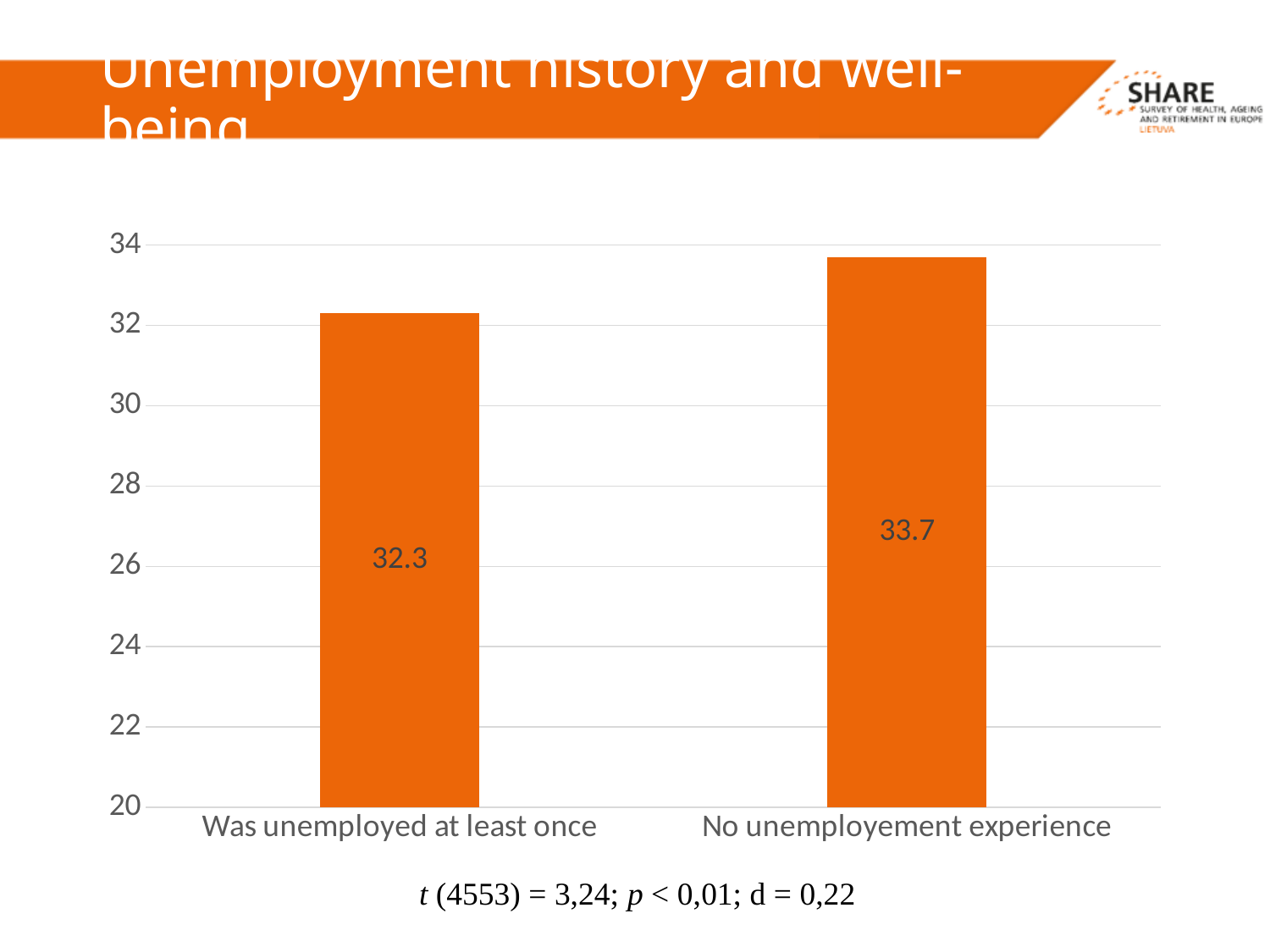
How many categories are shown on the chart? 2 What is the lowest value shown on the vertical axis? 20 Is the value for "No unemployement experience" greater or less than 34? less Is the value for "Was unemployed at least once" greater or less than 32? greater What is the value for "No unemployement experience"? 33.7 What is the value for "Was unemployed at least once"? 32.3 Which is larger, the value for "Was unemployed at least once" or for "No unemployement experience"? No unemployement experience What kind of chart is shown on the slide? Bar chart What colour are the bars in the chart? Orange Which category has the lowest value? Was unemployed at least once What is the difference between the values for "No unemployement experience" and "Was unemployed at least once"? 1.4 Which category has the highest value? No unemployement experience